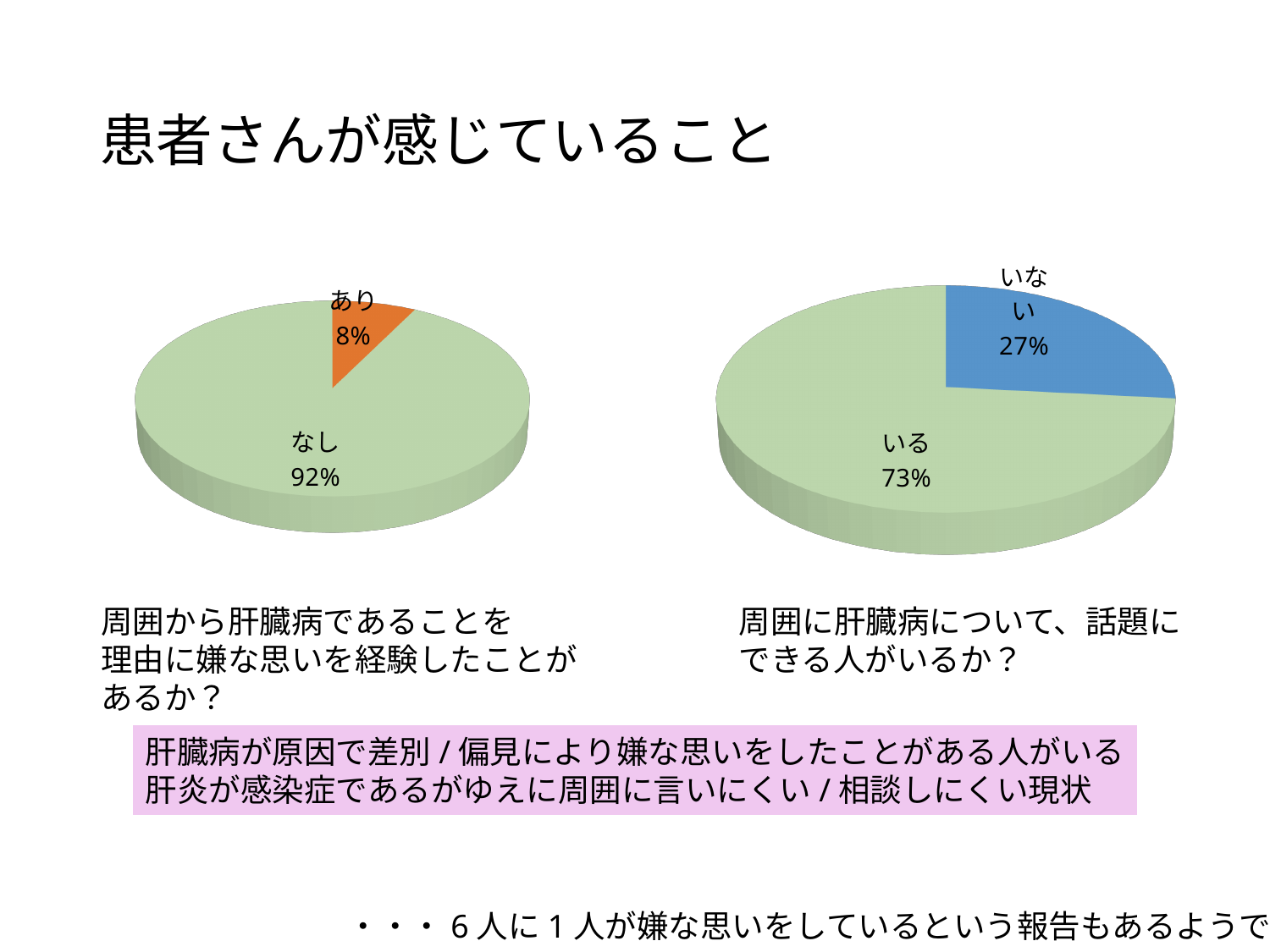
In the left pie chart, which slice is the largest? なし In the right pie chart, what percentage is shown for いる? 73% In the right pie chart, what is the difference in percentage points between いる and いない? 46 What type of chart is the right chart on the slide? pie chart How many slices does the left pie chart have? 2 In the right pie chart, which slice is the smallest? いない In the right pie chart, what colour is the いない slice? blue In the left pie chart, what is the difference in percentage points between なし and あり? 84 In the right pie chart, which is larger, いる or いない? いる In the left pie chart, what percentage is shown for あり? 8% In the right pie chart, what percentage is shown for いない? 27% In the left pie chart, what percentage is shown for なし? 92%